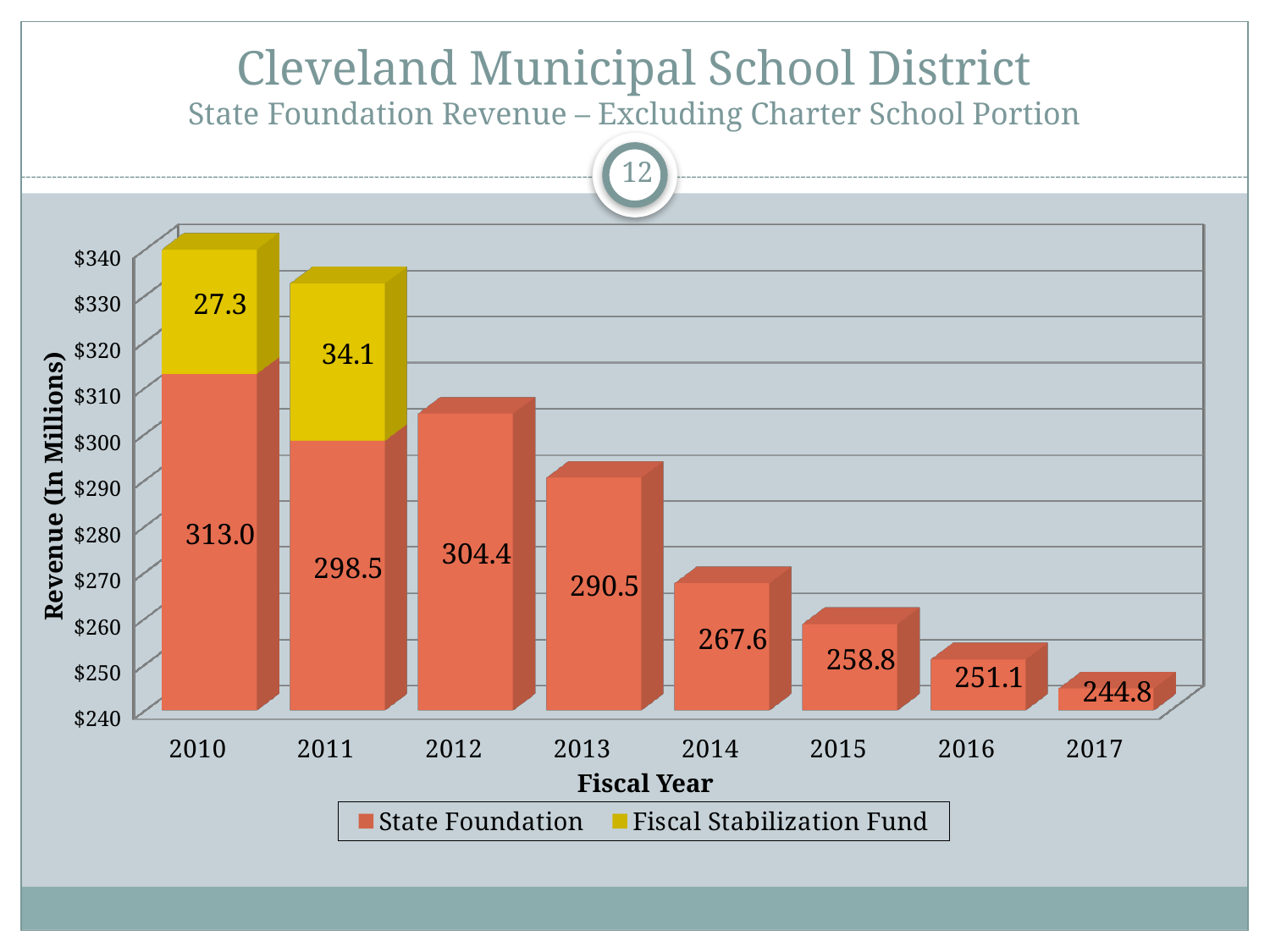
How many series does the legend list? 2 What is the State Foundation value for fiscal year 2017? 244.8 Which is larger, the State Foundation value for 2012 or for 2013? 2012 Which fiscal year has the highest State Foundation value? 2010 What kind of chart is shown on the slide? Stacked bar chart What is the total of the stacked bar for fiscal year 2010? 340.3 What is the State Foundation value for fiscal year 2012? 304.4 What is the Fiscal Stabilization Fund value for fiscal year 2011? 34.1 Which fiscal year has the lowest State Foundation value? 2017 What is the difference between the State Foundation values for 2010 and 2011? 14.5 What is the total of the stacked bar for fiscal year 2011? 332.6 How many fiscal years are shown on the x axis? 8